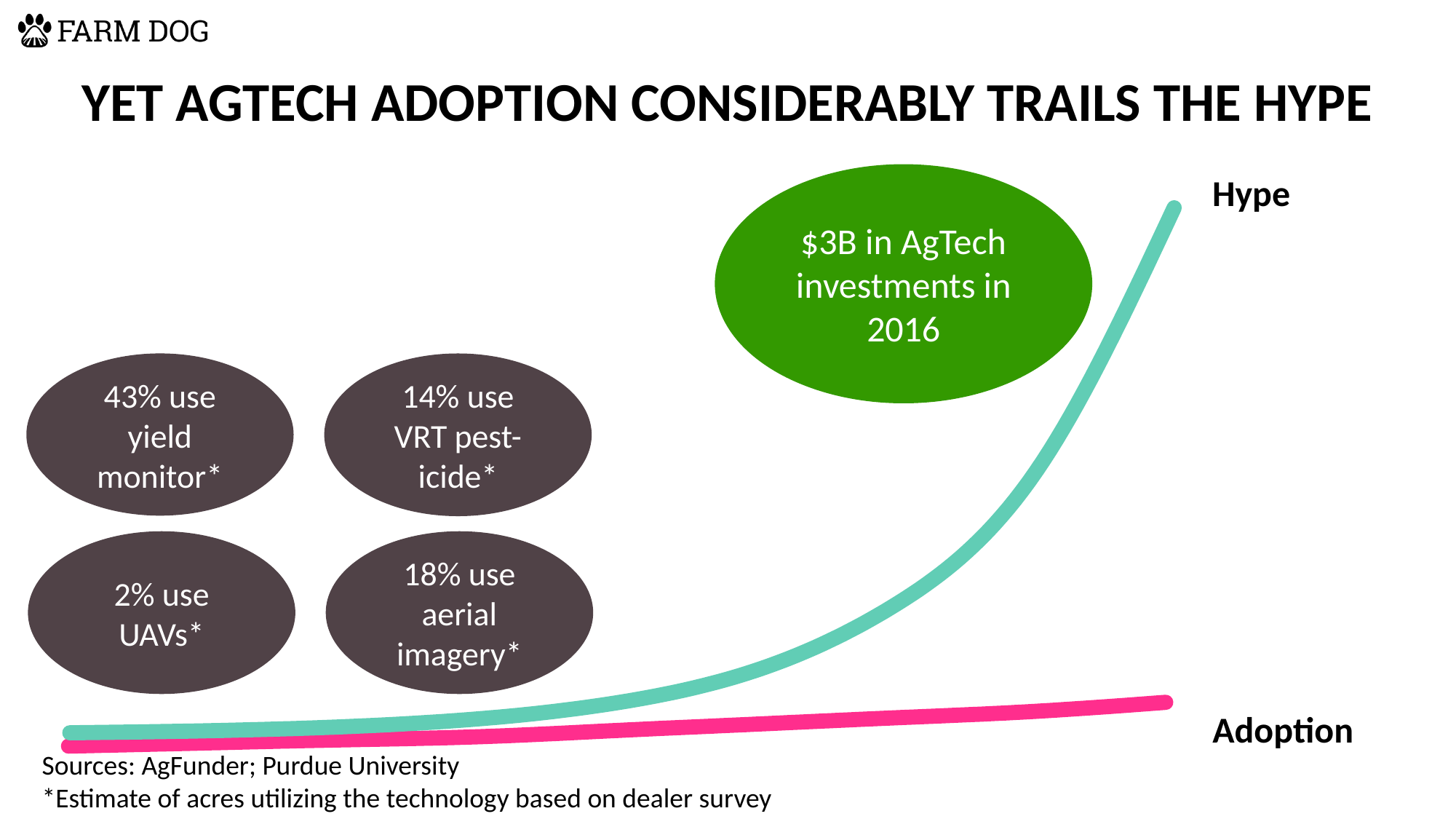
Of the four adoption percentages shown, which technology has the highest share? yield monitor What percentage use VRT pesticide, according to the slide? 14% What percentage use aerial imagery, according to the slide? 18% At the right end of the chart, which line is higher, Hype or Adoption? Hype Of the four adoption percentages shown, which technology has the lowest share? UAVs What kind of chart is shown on the slide? line chart What are the two lines on the chart labelled? Hype and Adoption How many lines are plotted on the chart? 2 Does the Hype line rise or fall from left to right? rises How much AgTech investment in 2016 does the green bubble cite? $3B What percentage of acres use a yield monitor, according to the slide? 43% What percentage use UAVs, according to the slide? 2%